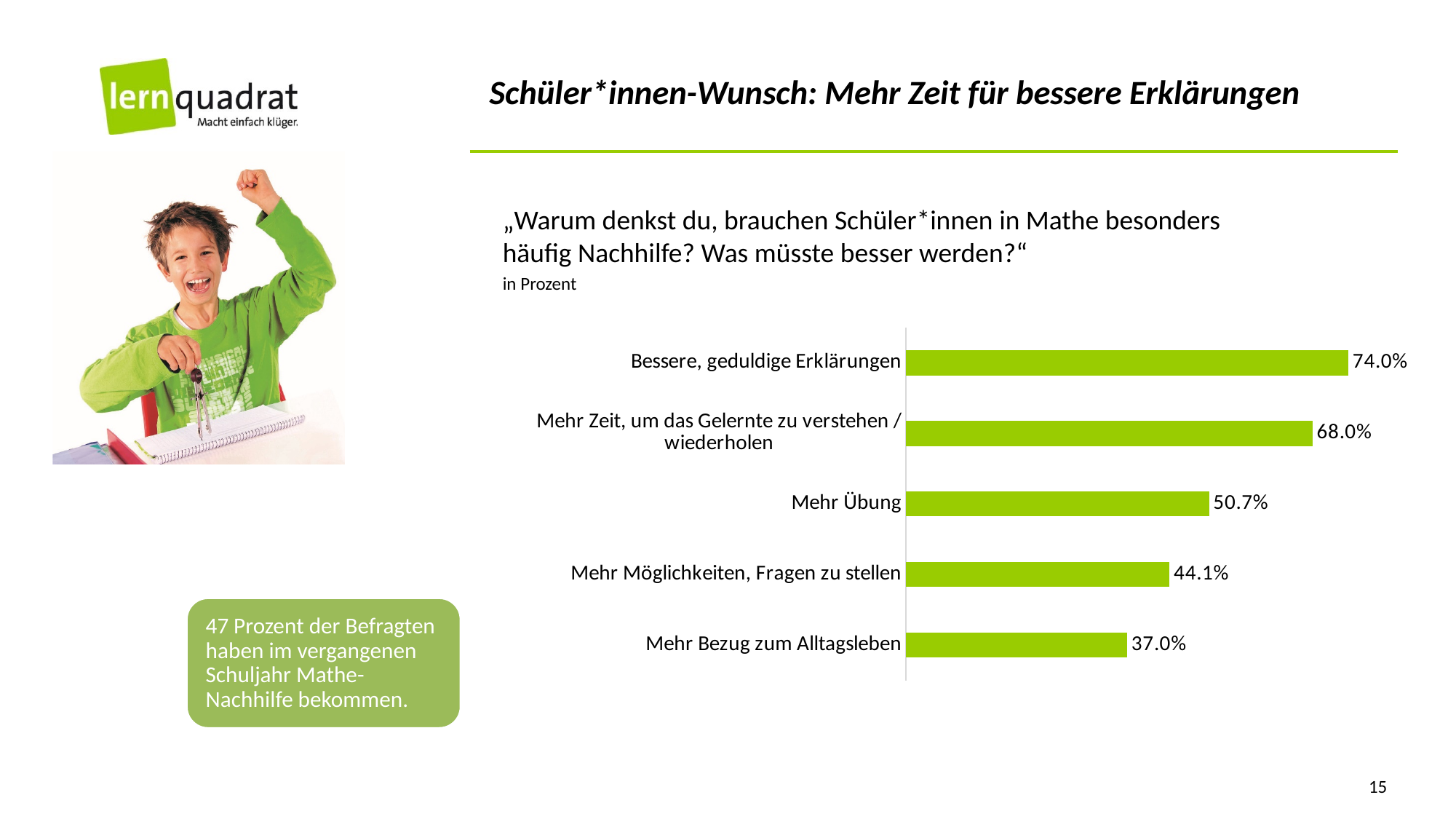
How many categories are shown in the chart? 5 What is the value for "Mehr Möglichkeiten, Fragen zu stellen"? 44.1% What is the difference between the values for "Mehr Übung" and "Mehr Bezug zum Alltagsleben"? 13.7% Which category has the lowest value? Mehr Bezug zum Alltagsleben What is the value for "Mehr Bezug zum Alltagsleben"? 37.0% What is the value for "Bessere, geduldige Erklärungen"? 74.0% What is the difference between the values for "Bessere, geduldige Erklärungen" and "Mehr Zeit, um das Gelernte zu verstehen / wiederholen"? 6.0% What colour are the bars in the chart? Green What is the value for "Mehr Übung"? 50.7% Which is larger: the value for "Mehr Übung" or the value for "Mehr Möglichkeiten, Fragen zu stellen"? Mehr Übung Which category has the highest value? Bessere, geduldige Erklärungen What kind of chart is shown on the slide? Bar chart